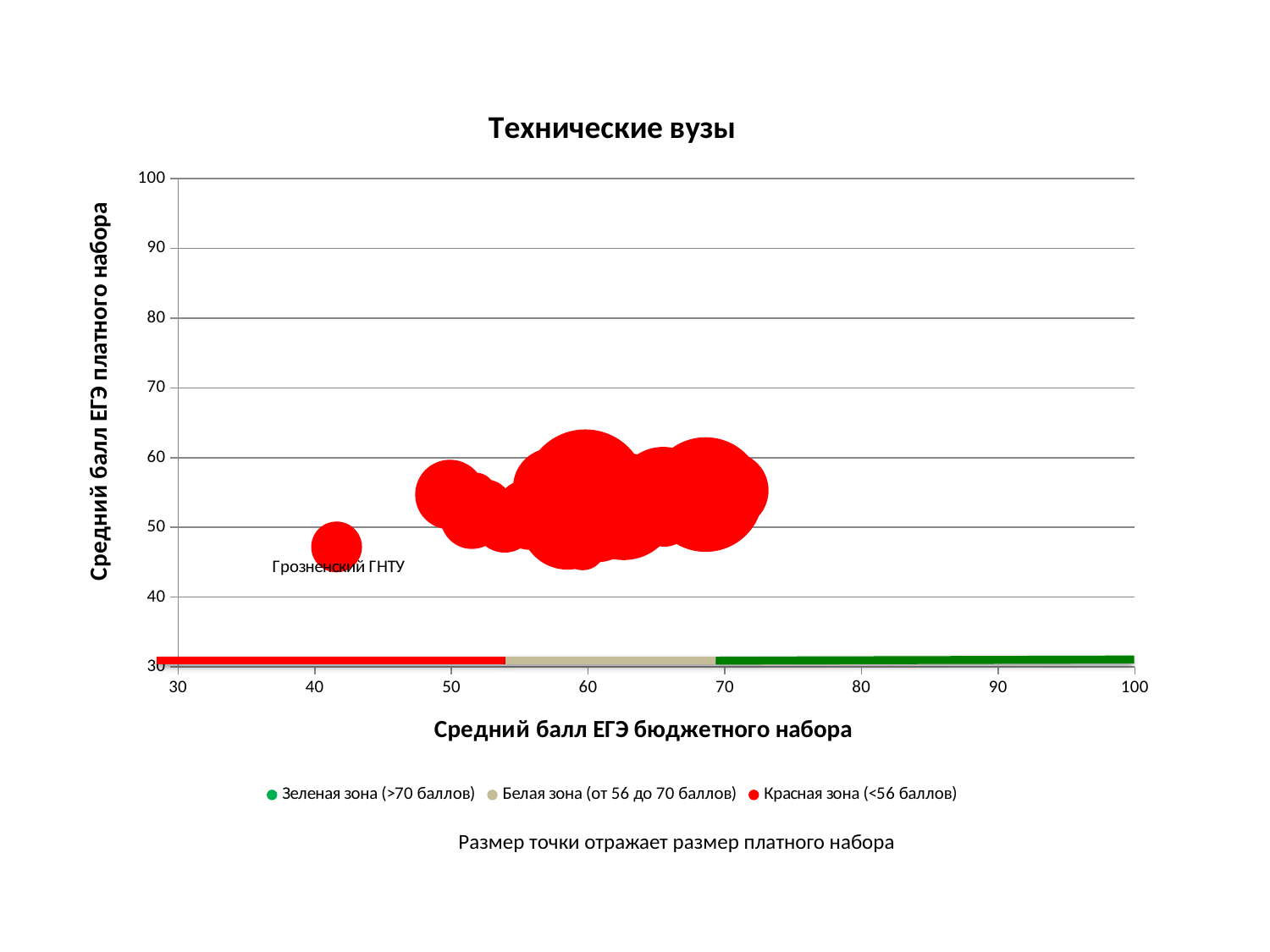
What is the highest value shown on the y axis? 100 Which university is labelled on the chart? Грозненский ГНТУ Is the value on the y axis (Средний балл ЕГЭ платного набора) for Грозненский ГНТУ greater or less than 40? greater What is the lowest value shown on the x axis? 30 How many series does the legend list? 3 Which zone (legend colour) do all the plotted bubbles belong to? Красная зона (<56 баллов) What is the title of the chart? Технические вузы Is the value on the x axis (Средний балл ЕГЭ бюджетного набора) for Грозненский ГНТУ greater or less than 50? less Which legend entry is shown in green? Зеленая зона (>70 баллов) Is the value on the y axis (Средний балл ЕГЭ платного набора) for Грозненский ГНТУ greater or less than 50? less What kind of chart is shown on the slide? Bubble chart